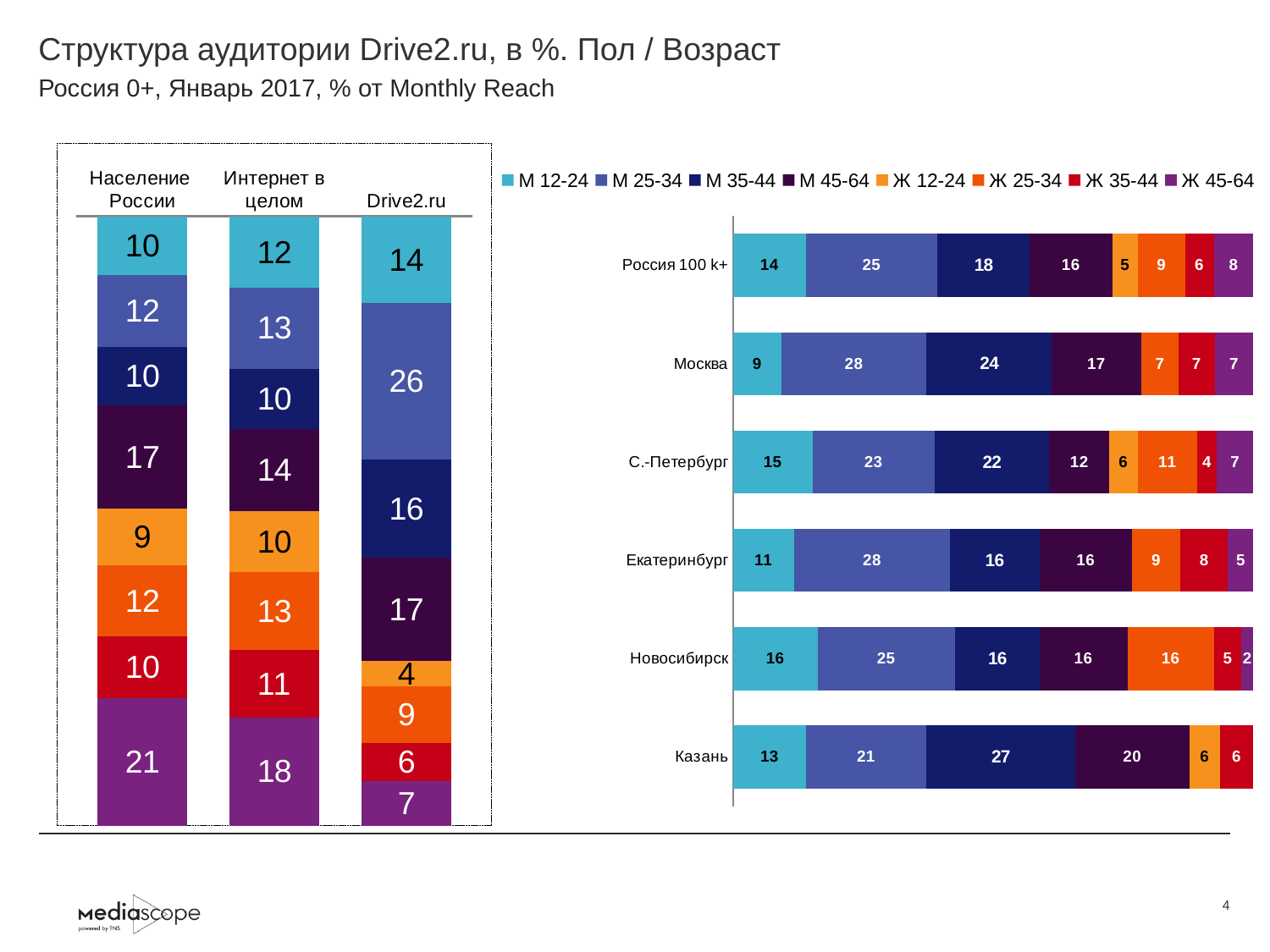
In the right chart, which city has the highest value for М 12-24? Новосибирск In the left chart, what is the value for М 25-34 in the Drive2.ru bar? 26 In the left chart, what is the difference between the Drive2.ru and Население России values for М 25-34? 16 In the right chart, what is the value for М 35-44 in Казань? 27 How many cities/regions are shown in the right chart? 6 How many series does the legend of the right chart list? 8 In the right chart, what is the value for М 25-34 in Москва? 28 In the left chart, what is the value for Ж 45-64 in the Население России bar? 21 In the right chart, which is larger: the М 35-44 value for Москва or for С.-Петербург? Москва In the right chart, which city has the lowest value for М 12-24? Москва In the right chart, what is the value for Ж 25-34 in С.-Петербург? 11 What kind of chart is the right chart? Stacked bar chart